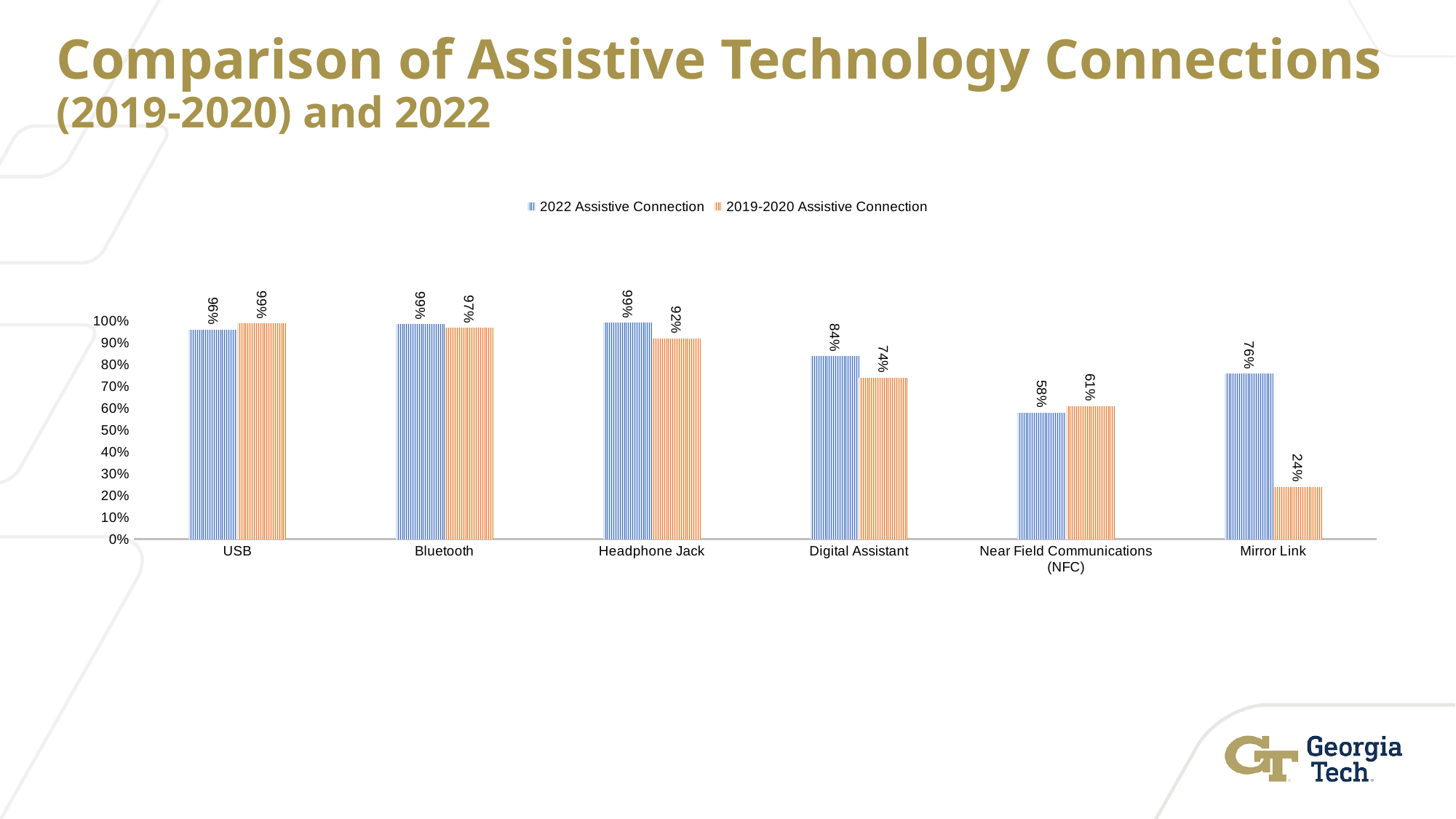
How many categories are shown on the x axis? 6 What is the difference between the 2022 and 2019-2020 Assistive Connection values for Digital Assistant? 10% Which category has the lowest 2019-2020 Assistive Connection value? Mirror Link What is the 2019-2020 Assistive Connection value for Headphone Jack? 92% What is the difference between the 2022 and 2019-2020 Assistive Connection values for Mirror Link? 52% What is the 2022 Assistive Connection value for Mirror Link? 76% What is the 2022 Assistive Connection value for Digital Assistant? 84% How many series does the legend list? 2 What kind of chart is shown on the slide? Bar chart Is the 2019-2020 Assistive Connection value for Mirror Link greater or less than 30%? less Which category has the lowest 2022 Assistive Connection value? Near Field Communications (NFC) For Near Field Communications (NFC), which is larger: the 2022 value or the 2019-2020 value? 2019-2020 Assistive Connection